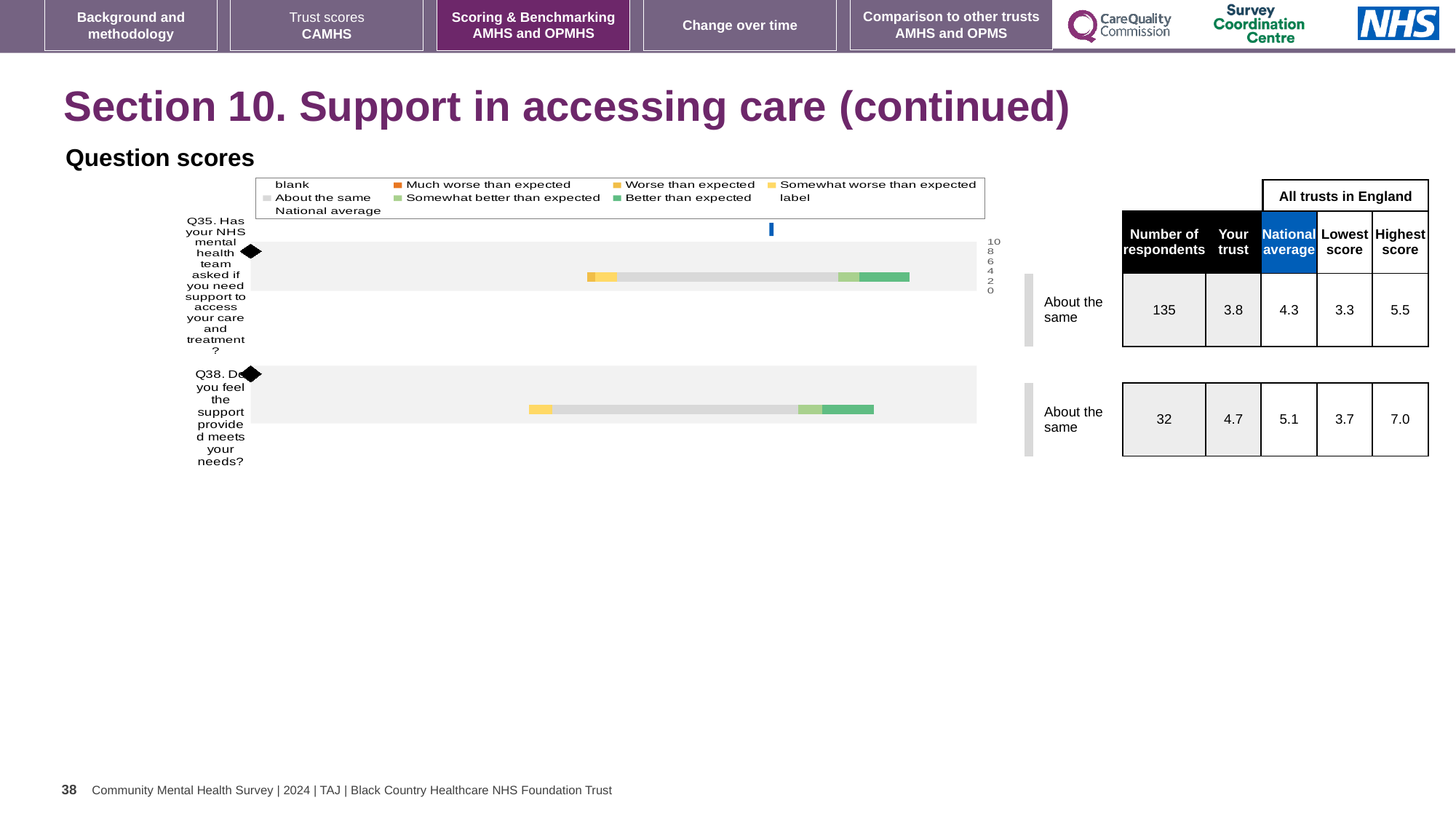
What is the national average score for Q38 (Do you feel the support provided meets your needs?)? 5.1 What is the difference between the national average and the 'Your trust' score for Q35? 0.5 Which question has the higher 'Your trust' score, Q35 or Q38? Q38 What colour represents 'Better than expected' in the legend? green What kind of chart is shown under 'Question scores'? bar chart What is the 'Your trust' score for Q35 (Has your NHS mental health team asked if you need support to access your care and treatment?)? 3.8 How many respondents answered Q35? 135 How many questions (categories) are plotted in the chart? 2 What is the difference between the highest and lowest scores for Q38? 3.3 Which question has the higher 'Highest score' value? Q38 What benchmark category is shown for Q38? About the same What is the lowest score among all trusts in England for Q35? 3.3